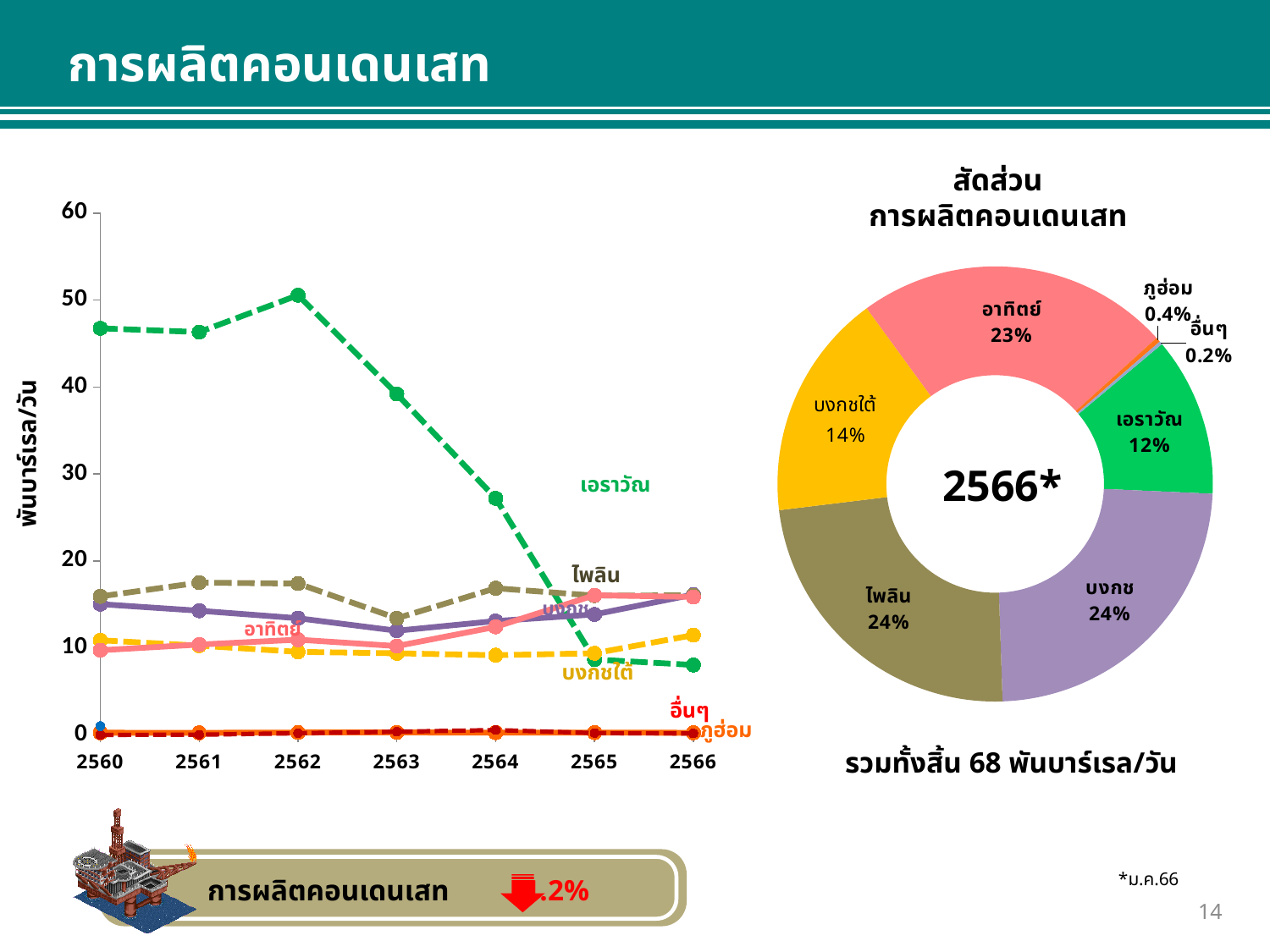
In the donut chart titled สัดส่วนการผลิตคอนเดนเสท, what share does อาทิตย์ have? 23% In the line chart on the left, is the value for เอราวัณ in 2562 greater or less than 40? greater In the donut chart titled สัดส่วนการผลิตคอนเดนเสท, which slice has the smallest share? อื่นๆ What kind of chart is the chart on the left side of the slide? Line chart In the donut chart titled สัดส่วนการผลิตคอนเดนเสท, what share does บงกชใต้ have? 14% In the donut chart titled สัดส่วนการผลิตคอนเดนเสท, how many percentage points larger is the share of อาทิตย์ than that of เอราวัณ? 11% In the donut chart titled สัดส่วนการผลิตคอนเดนเสท, what share does เอราวัณ have? 12% In the line chart on the left, does the เอราวัณ line rise or fall from 2562 to 2566? fall In the line chart on the left, which series has the highest value in 2560? เอราวัณ In the line chart on the left, is the value for เอราวัณ in 2566 greater or less than 10? less In the donut chart titled สัดส่วนการผลิตคอนเดนเสท, which is larger, the share of อาทิตย์ or the share of บงกชใต้? อาทิตย์ In the donut chart titled สัดส่วนการผลิตคอนเดนเสท, how many slices are there? 7